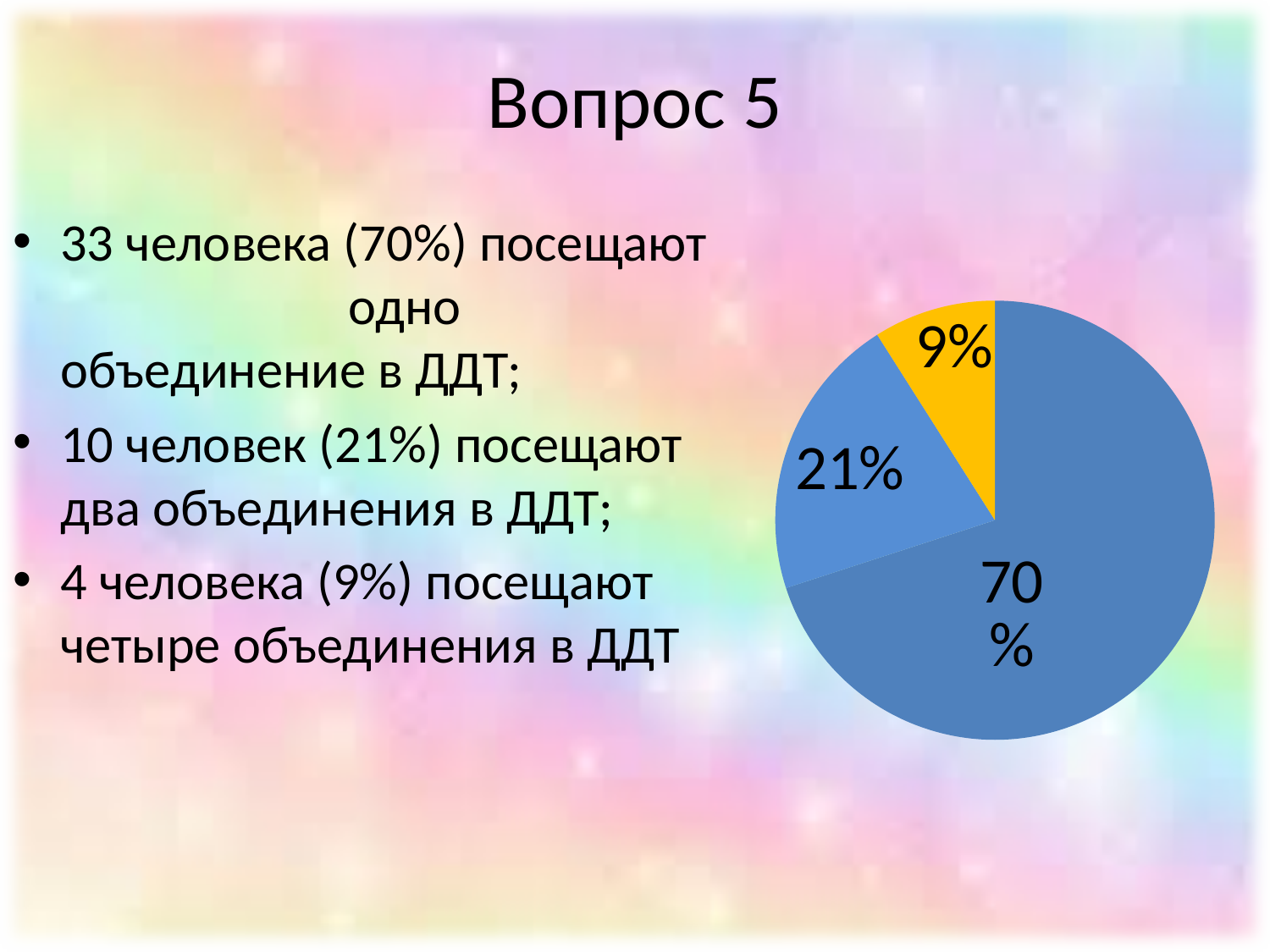
What percentage is shown on the yellow slice of the pie chart? 9% What percentage is shown on the lighter blue slice of the pie chart? 21% Is the share of the largest slice greater or less than 50%? greater What colour is the smallest slice of the pie chart? yellow How many slices does the pie chart have? 3 What percentage is shown on the dark blue slice of the pie chart? 70% What is the difference in percentage points between the 21% slice and the 9% slice? 12 What is the difference in percentage points between the 70% slice and the 21% slice? 49 What is the value shown on the smallest slice of the pie chart? 9% What kind of chart is shown on the slide? pie chart Which slice is larger, the yellow slice or the lighter blue slice? the lighter blue slice What is the value shown on the largest slice of the pie chart? 70%